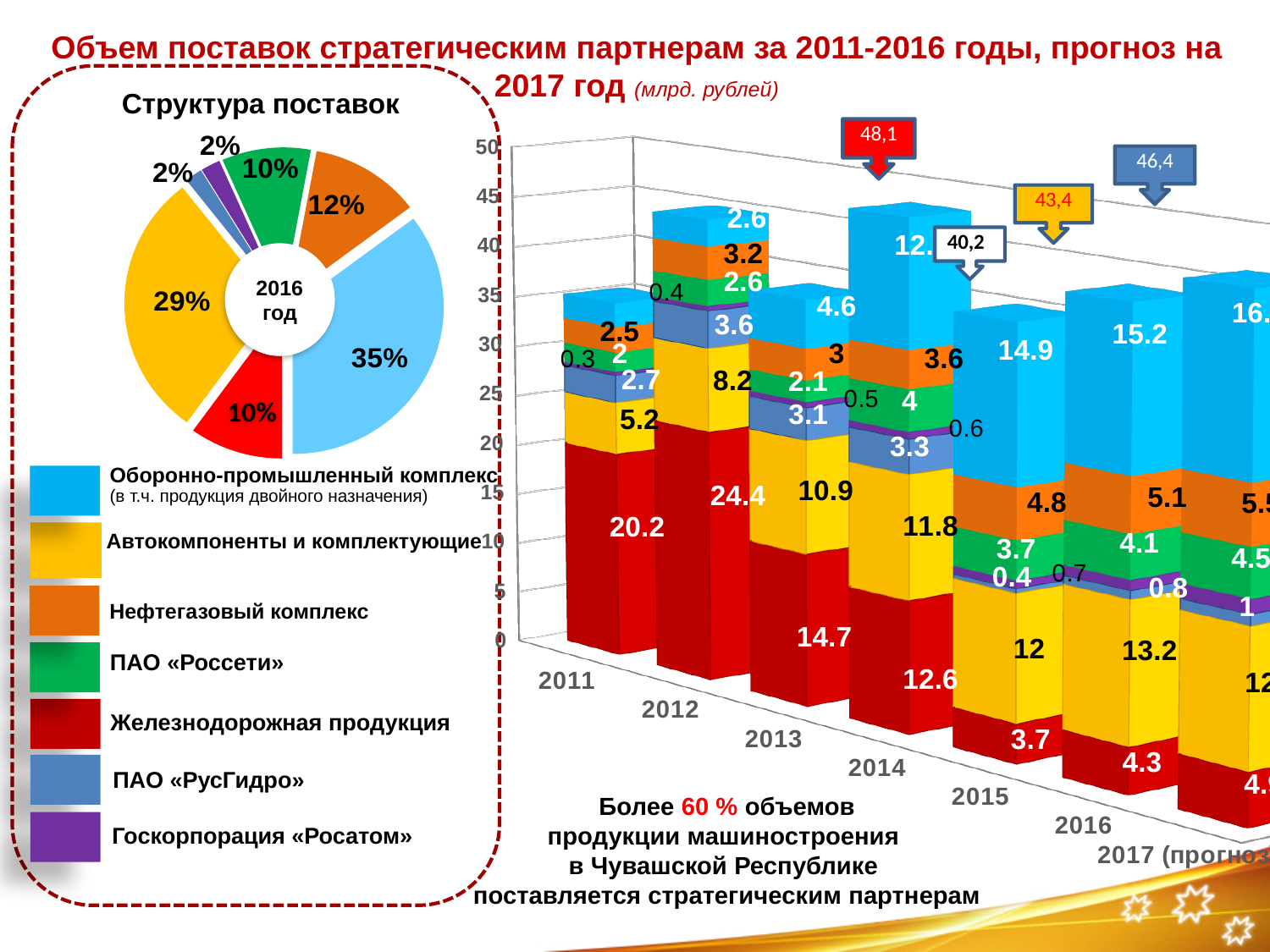
In the bar chart on the right, what is the value for Железнодорожная продукция in 2011? 20.2 In the bar chart on the right, what is the value for Железнодорожная продукция in 2012? 24.4 In the bar chart on the right, which is larger: Железнодорожная продукция in 2012 or in 2014? 2012 In the bar chart on the right, what is the difference between the Железнодорожная продукция values for 2012 and 2013? 9.7 In the bar chart on the right, what is the value for Автокомпоненты и комплектующие in 2016? 13.2 In the pie chart "Структура поставок", which category has the largest share? Оборонно-промышленный комплекс In the pie chart "Структура поставок", what share does Автокомпоненты и комплектующие have? 29% In the pie chart "Структура поставок", how many slices are there? 7 In the pie chart "Структура поставок", what share does Оборонно-промышленный комплекс have? 35% What kind of chart is the chart on the right of the slide? Bar chart In the bar chart on the right, how many years are shown on the x axis? 7 How many series does the legend on the slide list? 7